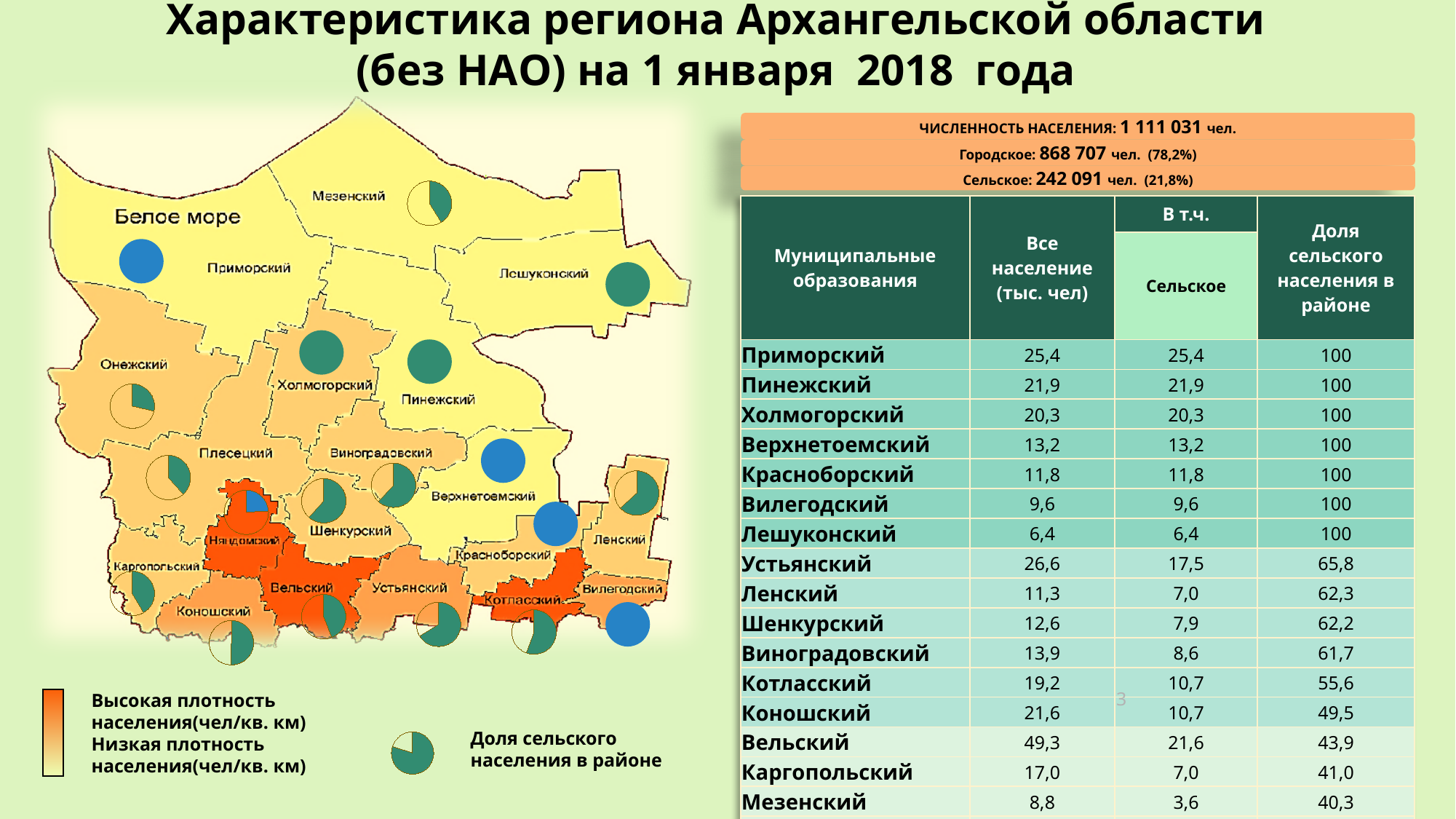
What percentage of the region's population is urban (Городское)? 78,2% What is the total population of the region shown at the top of the table? 1 111 031 чел. What kind of chart is drawn on each district of the map to show the share of rural population? pie chart Which municipality in the table has the highest total population? Вельский How many municipalities in the table have a rural population share of 100? 7 Which municipality in the table has the lowest total population? Лешуконский What is the difference between the total population and the rural population of Устьянский district (тыс. чел)? 9,1 According to the map legend, what does the dark orange colour indicate? Высокая плотность населения (чел/кв. км) According to the table, what is the total population (тыс. чел) of Вельский district? 49,3 According to the table, what is the share of rural population in Мезенский district? 40,3 Which district has a larger total population, Вельский or Устьянский? Вельский How many municipalities are listed in the table? 16